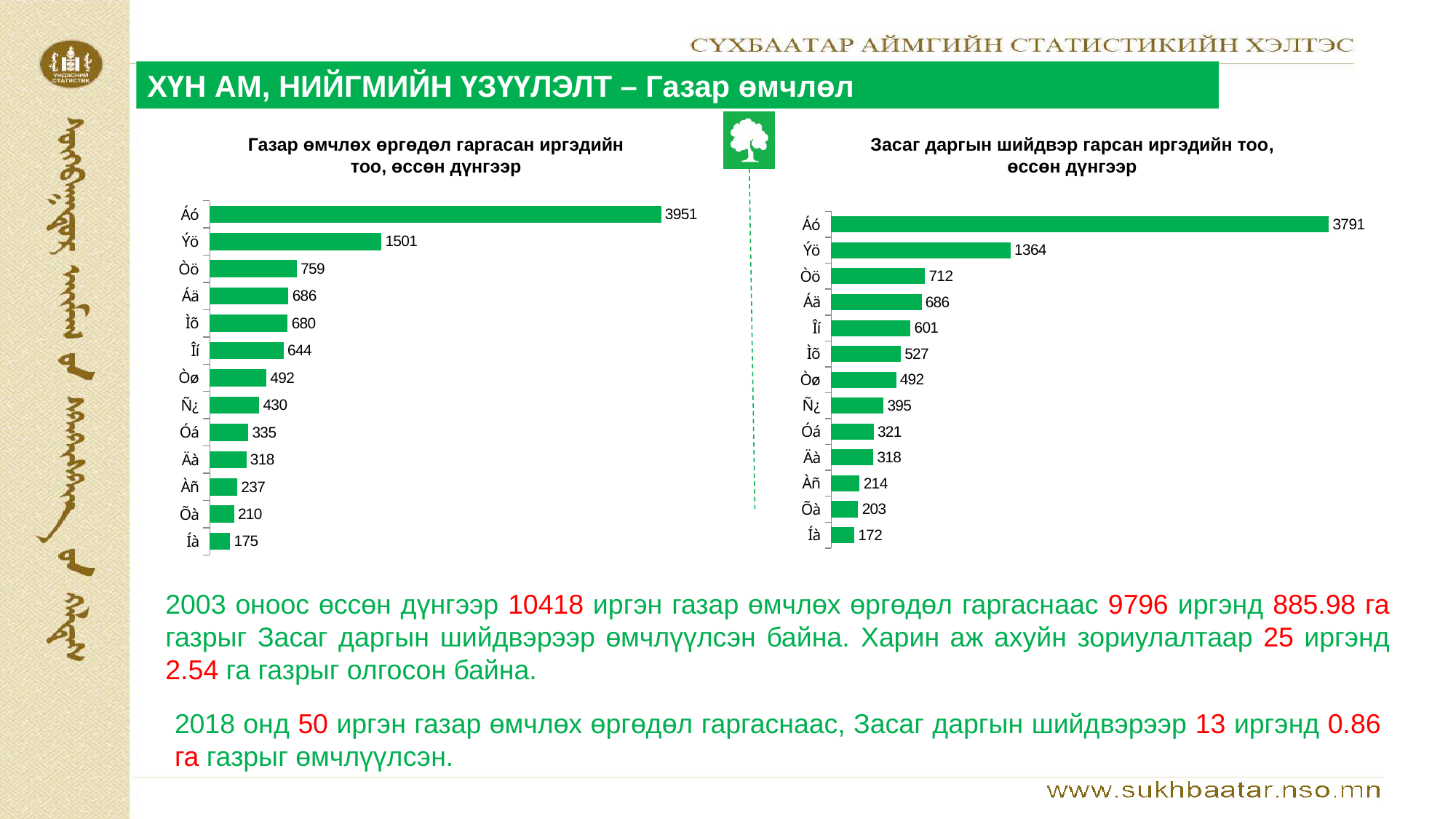
Which is larger: the value for Òö in the left chart or the value for Òö in the right chart? Left chart (759) In the right chart (Засаг даргын шийдвэр гарсан иргэдийн тоо, өссөн дүнгээр), what is the value of the top bar labelled Áó? 3791 What type of chart is used on the right side of the slide? Bar chart In the left chart, what is the value for the category labelled Ýö? 1501 In the right chart, what is the difference between the values for Òö and Áä? 26 In the left chart, which category has the lowest value? Íà In the right chart, what is the value for the category labelled Ýö? 1364 In the left chart (Газар өмчлөх өргөдөл гаргасан иргэдийн тоо, өссөн дүнгээр), what is the value of the top bar labelled Áó? 3951 In the left chart, what is the difference between the values for Áó and Ýö? 2450 How many bars does the left chart have? 13 What is the title of the left chart? Газар өмчлөх өргөдөл гаргасан иргэдийн тоо, өссөн дүнгээр In the right chart, what is the value of the smallest bar? 172